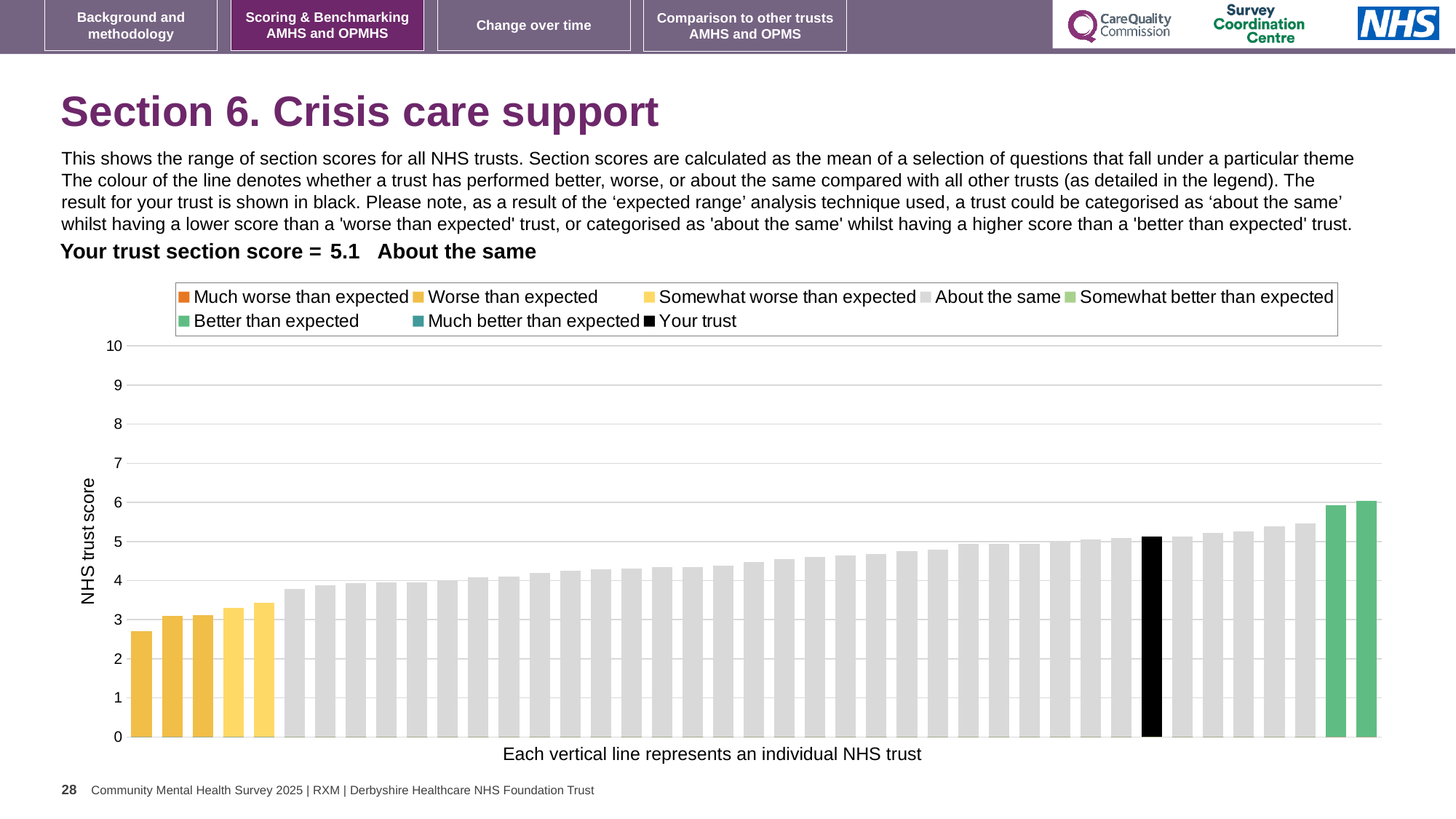
What is the label on the y axis of the chart? NHS trust score How many entries does the chart legend list? 8 Is the value of the highest bar in the chart greater or less than 5? greater Which category is your trust placed in for this section? About the same Is the value of the lowest bar in the chart greater or less than 3? less What kind of chart is shown on the slide? Bar chart Do the bar values rise or fall from left to right along the x axis? rise Which is larger, the leftmost bar or the rightmost bar? the rightmost bar How many bars are coloured as 'Better than expected' (green)? 2 What is the section score for your trust shown on the slide? 5.1 How many bars are coloured as 'Worse than expected' (darker yellow)? 3 Is the value of the highest bar in the chart greater or less than 7? less